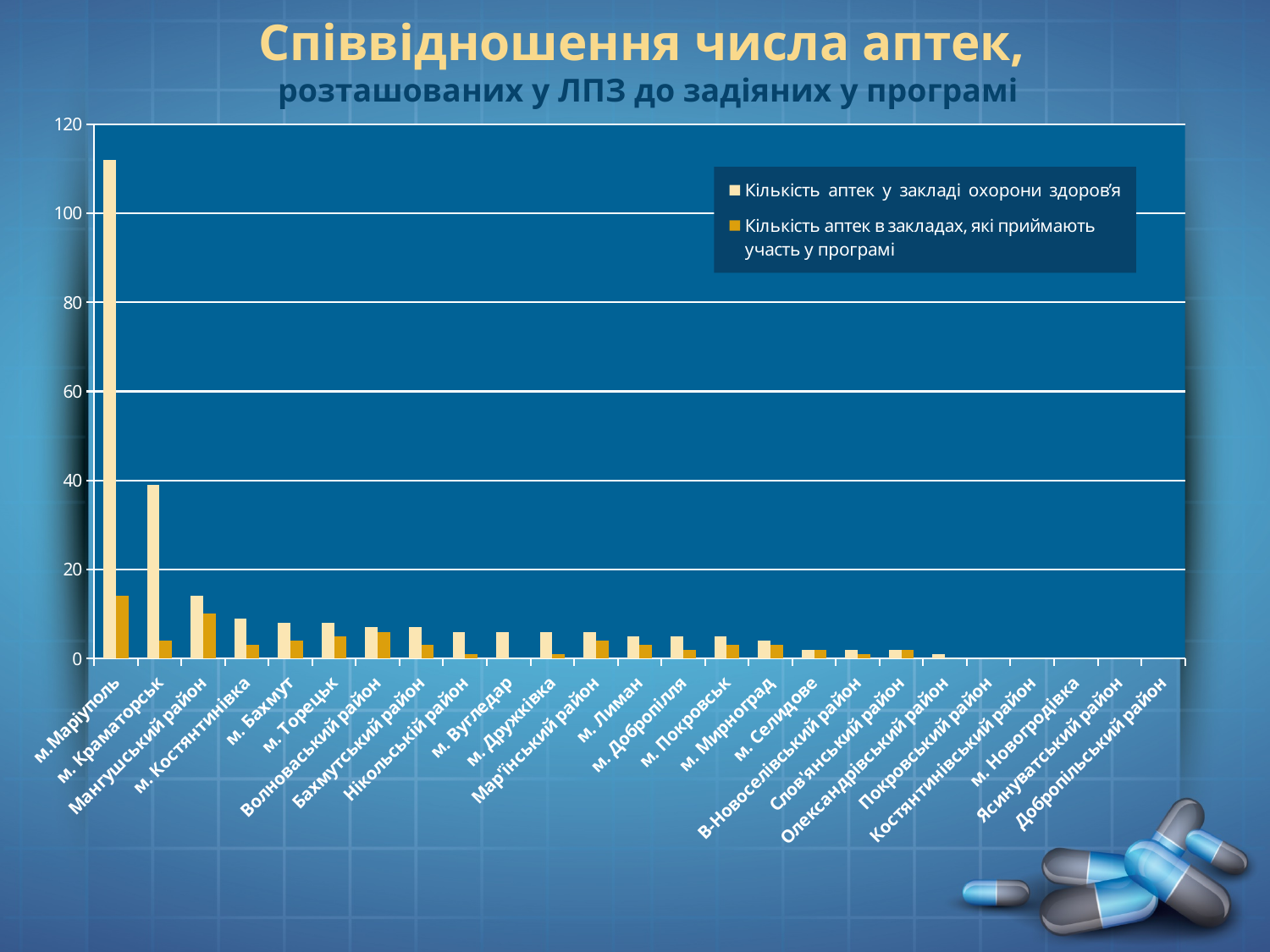
Which has a larger value for 'Кількість аптек в закладах, які приймають участь у програмі': м.Маріуполь or м. Краматорськ? м.Маріуполь What kind of chart is shown on the slide? bar chart How many series does the legend list? 2 Do the values for 'Кількість аптек у закладі охорони здоров'я' generally rise or fall from left to right along the x axis? fall Is the value for 'Кількість аптек у закладі охорони здоров'я' in м.Маріуполь greater or less than 100? greater Which category has the highest value for 'Кількість аптек в закладах, які приймають участь у програмі'? м.Маріуполь Which category has the highest value for 'Кількість аптек у закладі охорони здоров'я'? м.Маріуполь Is the value for 'Кількість аптек у закладі охорони здоров'я' in м. Краматорськ greater or less than 20? greater Is the value for 'Кількість аптек у закладі охорони здоров'я' in Мангушський район greater or less than 20? less Which has a larger value for 'Кількість аптек у закладі охорони здоров'я': м.Маріуполь or м. Краматорськ? м.Маріуполь What is the first line of the chart's title? Співвідношення числа аптек, How many categories are shown along the x axis? 25